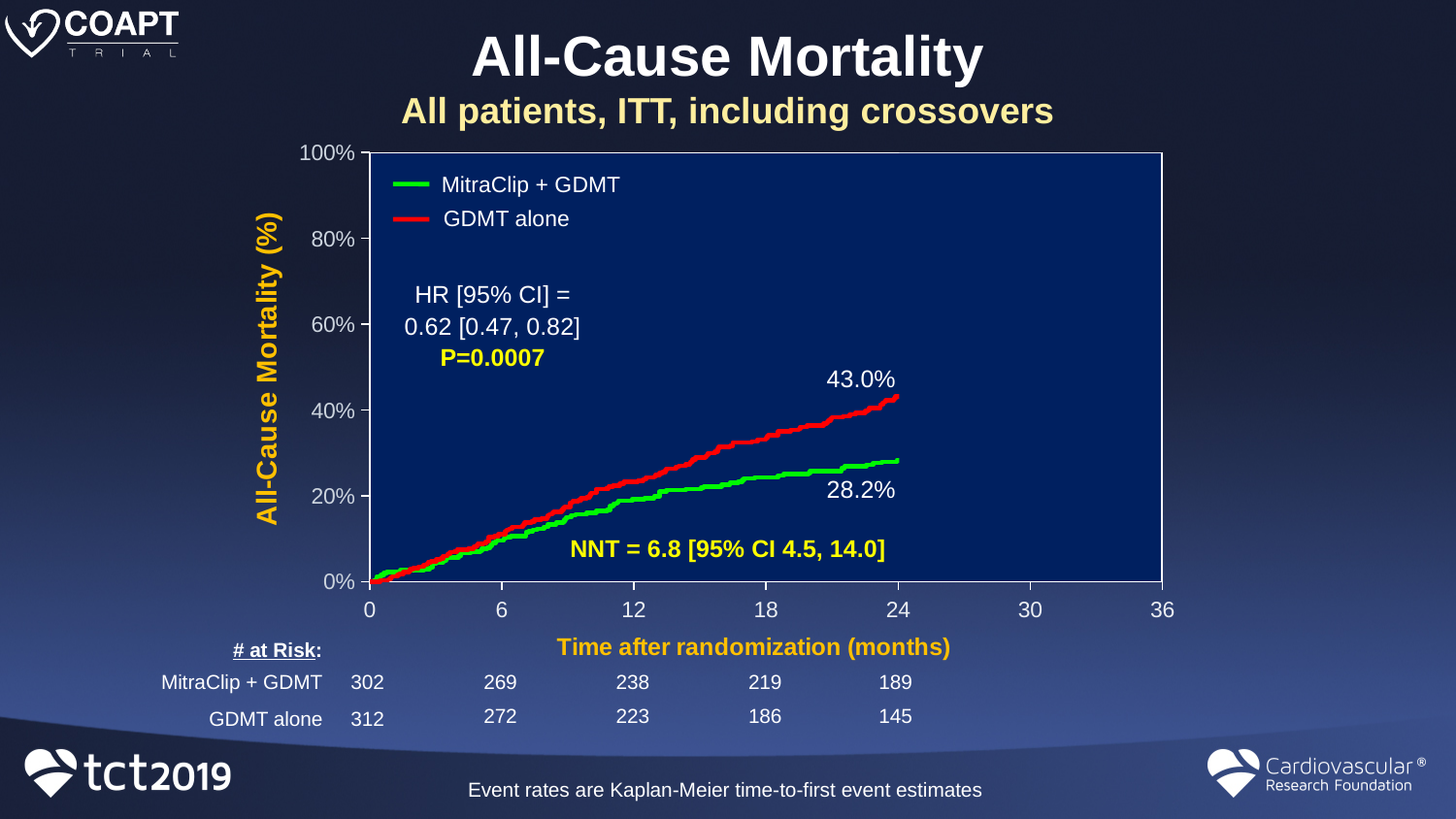
Which colour represents the GDMT alone group in the chart? Red What is the all-cause mortality rate for MitraClip + GDMT at 24 months? 28.2% Is the all-cause mortality for MitraClip + GDMT at 6 months greater or less than 20%? less How many patients were at risk in the MitraClip + GDMT group at 12 months? 238 Is the all-cause mortality for GDMT alone at 18 months greater or less than 20%? greater How many patients were at risk in the GDMT alone group at 24 months? 145 What kind of chart is shown on the slide? Line chart (Kaplan-Meier curve) What is the difference in all-cause mortality at 24 months between GDMT alone and MitraClip + GDMT? 14.8 percentage points Do the mortality curves rise or fall as time after randomization increases? Rise What is the all-cause mortality rate for GDMT alone at 24 months? 43.0% How many series does the legend list? 2 Which group has the higher all-cause mortality at 24 months? GDMT alone